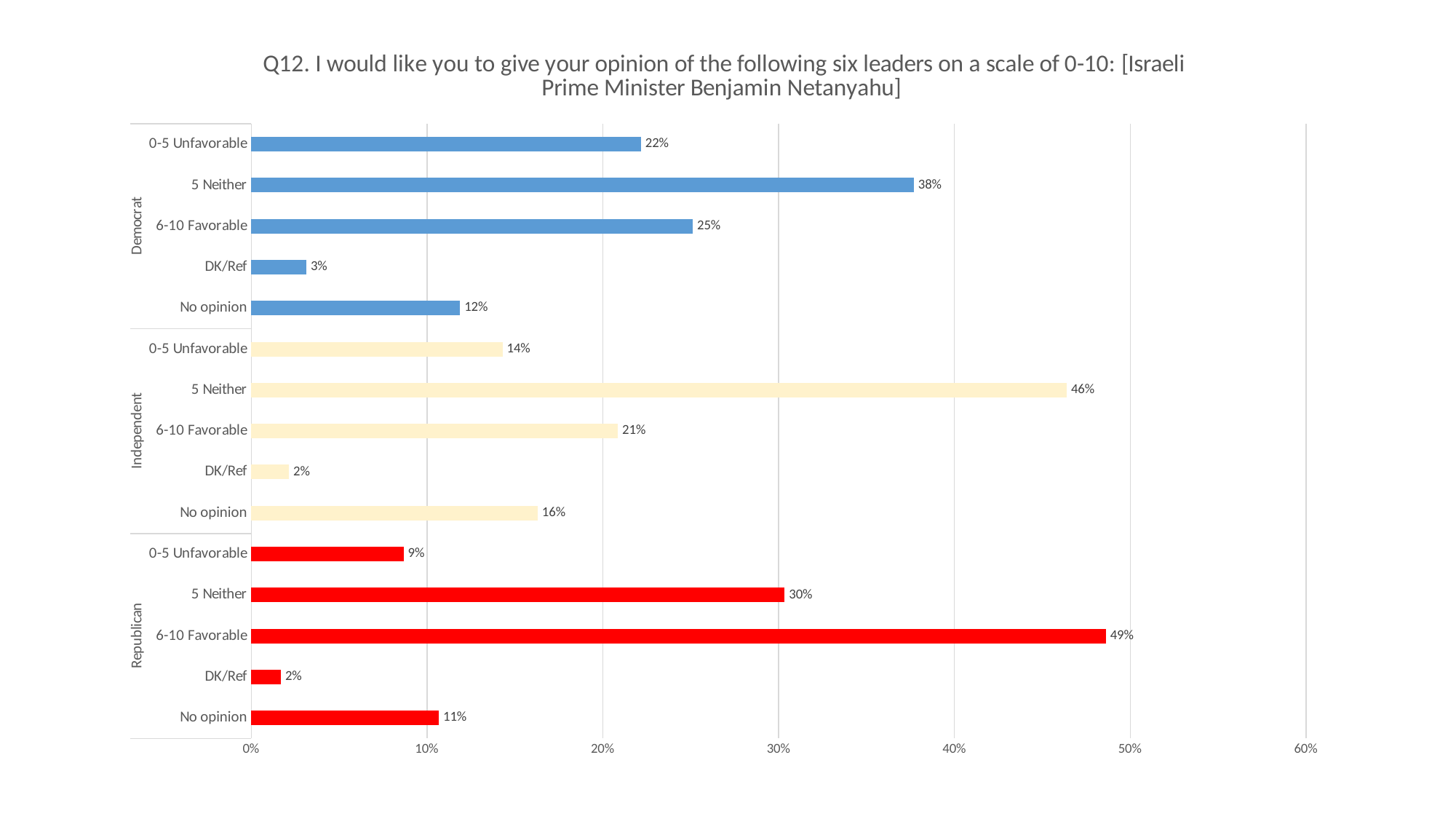
What colour are the bars for the Republican group? Red Which response category has the lowest value among Independents? DK/Ref Which is larger: '0-5 Unfavorable' among Democrats or '0-5 Unfavorable' among Republicans? Democrats Which response category has the highest value among Democrats? 5 Neither What is the difference between the '6-10 Favorable' values for Republicans and Democrats? 24% Is the value for '5 Neither' among Republicans greater or less than 20%? greater What kind of chart is shown on the slide? Bar chart What is the value for 'No opinion' among Democrats? 12% What is the value for '5 Neither' among Independents? 46% How many bars are plotted in the chart? 15 What is the value for '6-10 Favorable' among Republicans? 49% What is the total of the 'DK/Ref' values across Democrats, Independents and Republicans? 7%